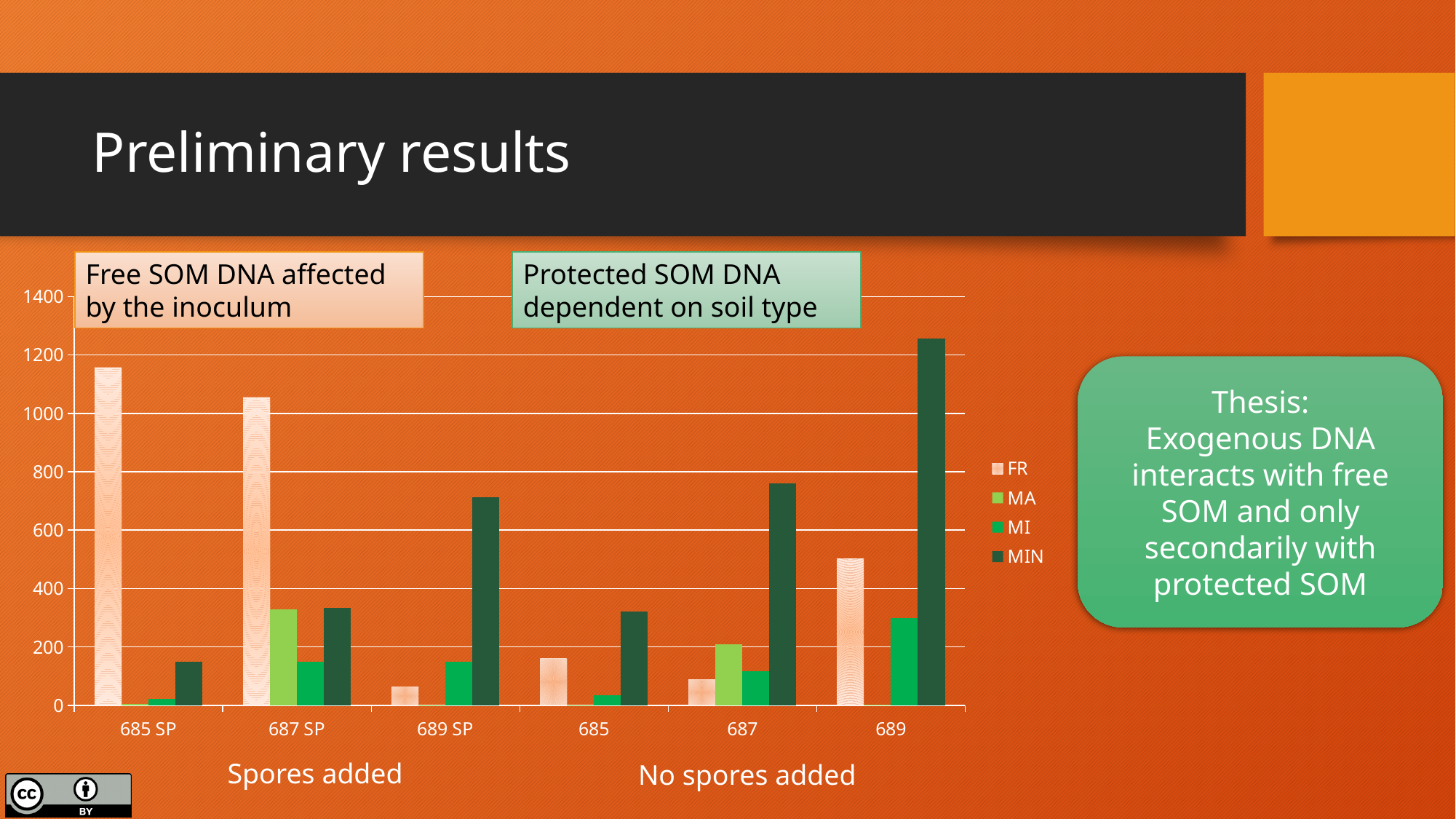
How many series does the chart legend list? 4 Which category has the highest FR value? 685 SP Which category has the highest MIN value? 689 How many categories are shown along the x axis of the chart? 6 Is the FR value for 689 SP greater or less than 200? less What kind of chart is shown on the slide? bar chart Is the MIN value for 689 greater or less than 1200? greater For 687 SP, which is larger, the FR value or the MIN value? FR Which series is listed last in the chart legend? MIN Is the MIN value for 689 SP greater or less than 600? greater For 689, which is larger, the FR value or the MIN value? MIN